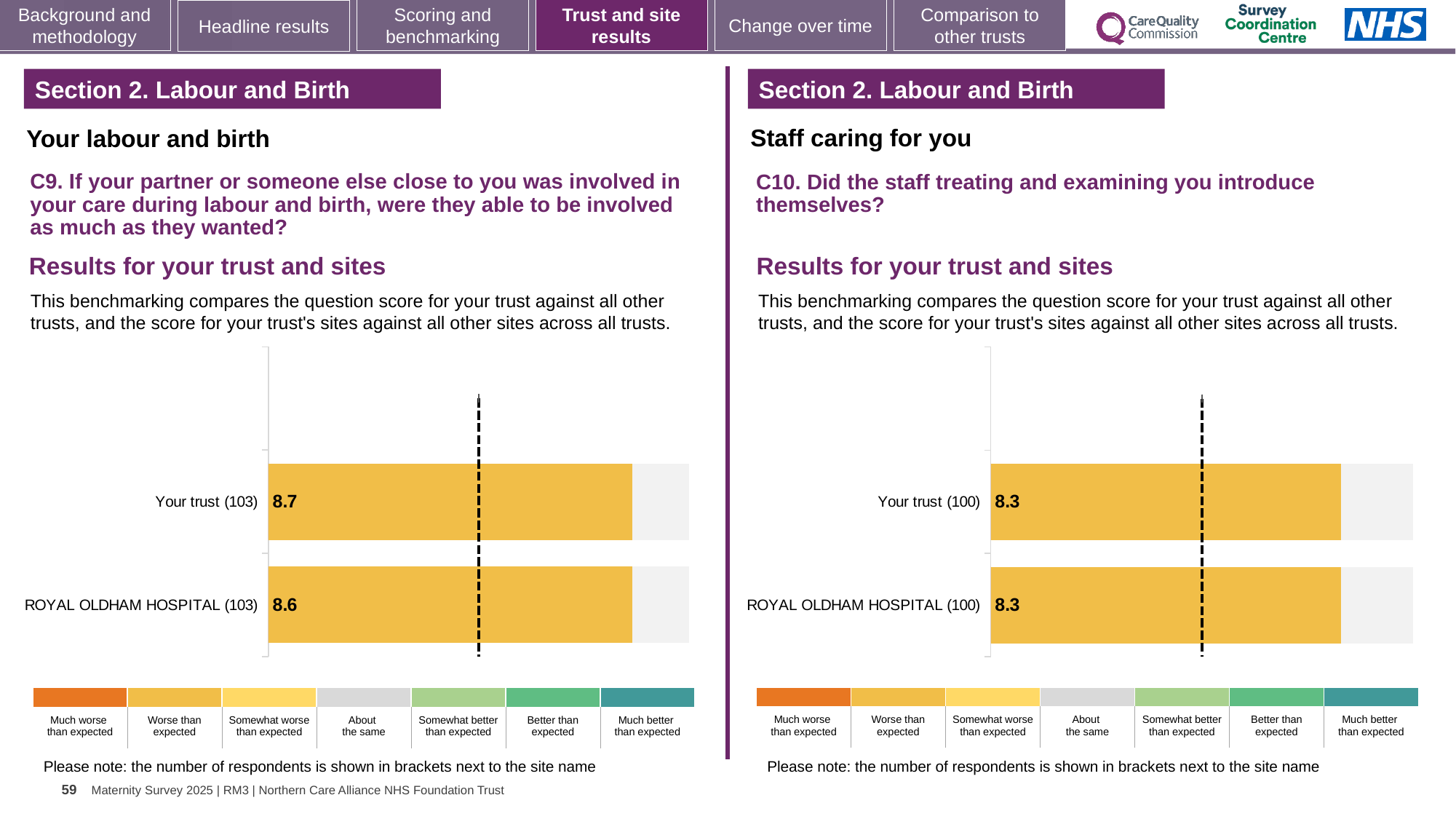
In the left chart (C9), what is the difference between the Your trust score and the ROYAL OLDHAM HOSPITAL score? 0.1 What type of chart is used in the left chart (C9)? Bar chart In the left chart (C9), how many bars are plotted? 2 In the left chart (C9), what is the score for ROYAL OLDHAM HOSPITAL? 8.6 In the right chart (C10), what is the score for Your trust? 8.3 In the left chart (C9), which has the higher score, Your trust or ROYAL OLDHAM HOSPITAL? Your trust In the right chart (C10), how many bars are plotted? 2 In the right chart (C10), what is the score for ROYAL OLDHAM HOSPITAL? 8.3 In the left chart (C9), how many respondents are shown in brackets for Your trust? 103 Is the Your trust score in the right chart (C10) greater or less than the Your trust score in the left chart (C9)? less In the right chart (C10), how many respondents are shown in brackets for ROYAL OLDHAM HOSPITAL? 100 In the left chart (C9), what is the score for Your trust? 8.7